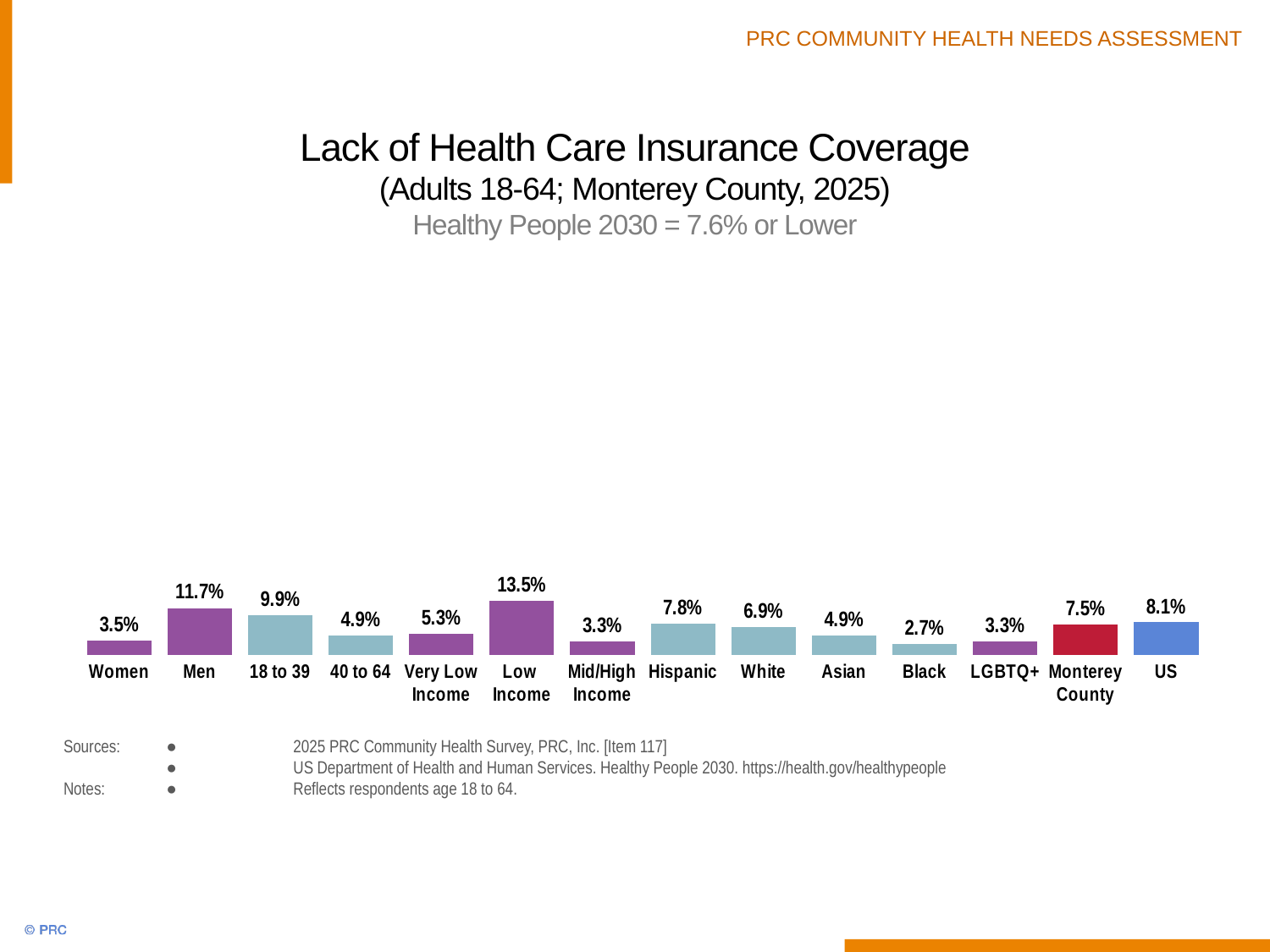
What is the value for Low Income? 13.5% What is the value for Monterey County? 7.5% What is the value for Men? 11.7% What is the Healthy People 2030 target stated in the chart subtitle? 7.6% or Lower What kind of chart is shown on the slide? Bar chart Which category has the lowest value? Black Which category has the highest value? Low Income What is the value for Black? 2.7% How many categories are shown in the chart? 14 What is the difference between the values for US and Monterey County? 0.6% Which is larger, the value for Hispanic or the value for White? Hispanic What is the difference between the values for Men and Women? 8.2%